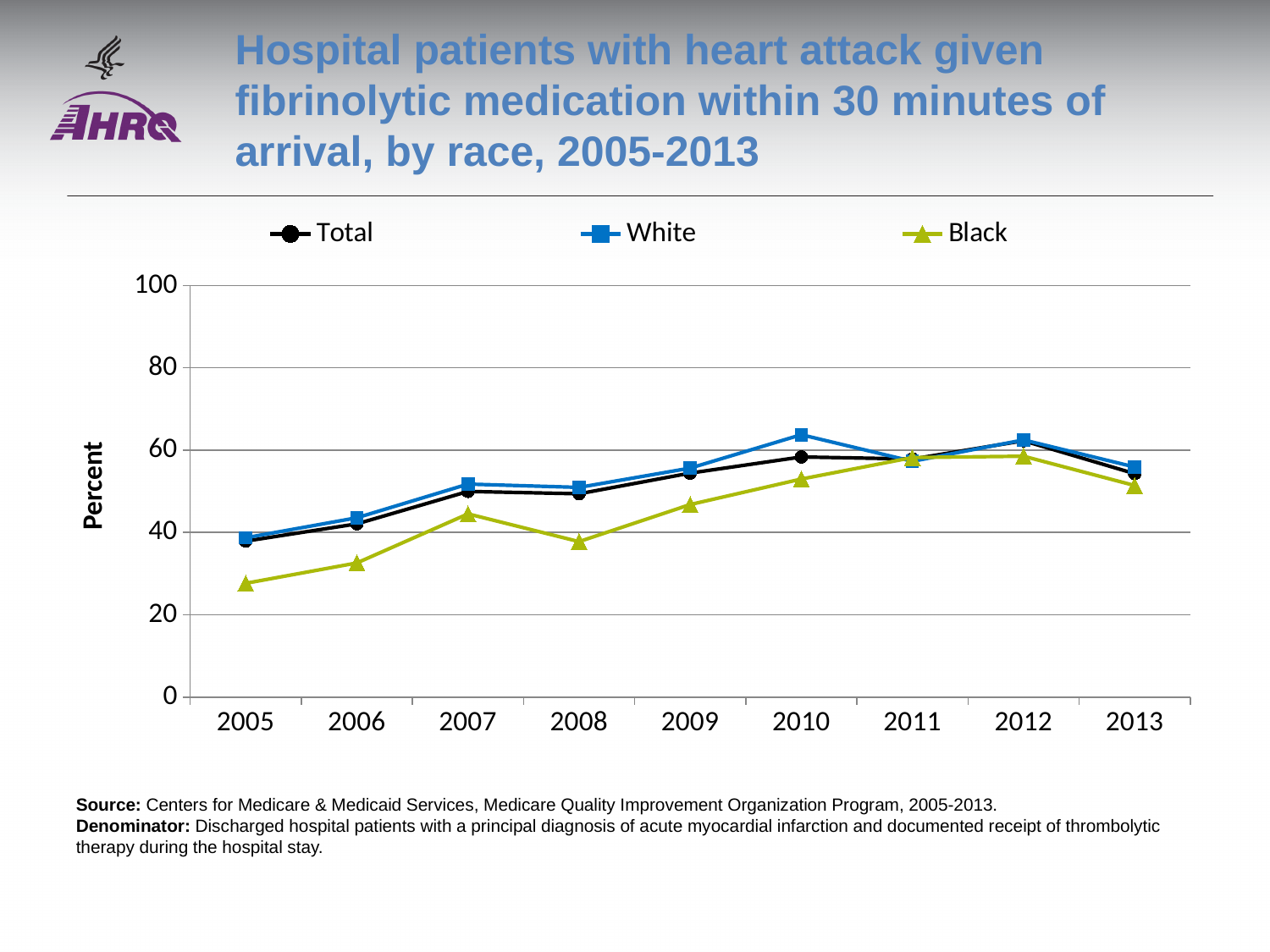
How many years are plotted along the x axis? 9 Does the value for Black rise or fall from 2005 to 2007? rise How many series does the legend list? 3 For the Black series, which is larger, the value in 2007 or the value in 2008? 2007 What kind of chart is shown on the slide? Line chart Is the value for White in 2010 greater or less than 60? greater Is the value for Black in 2013 greater or less than 60? less Is the value for Black in 2005 greater or less than 40? less In which year is the value for White highest? 2010 In which year is the value for Black lowest? 2005 What is the label on the y axis? Percent In 2005, which is larger, the value for White or the value for Black? White